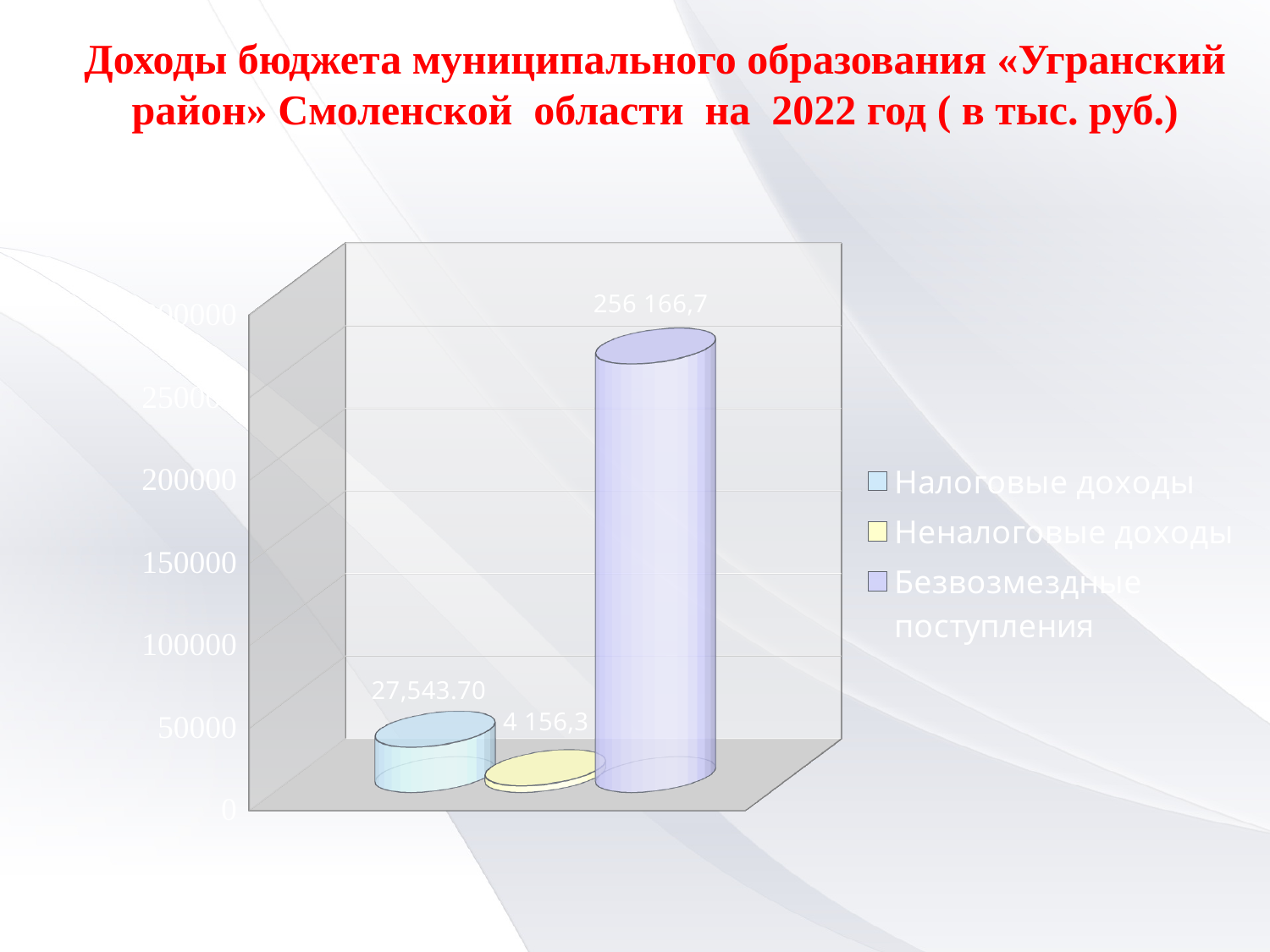
How many series does the legend list? 3 What is the value for Неналоговые доходы? 4 156,3 What colour is the bar for Неналоговые доходы? yellow What is the value for Безвозмездные поступления? 256 166,7 Which is larger, Налоговые доходы or Неналоговые доходы? Налоговые доходы What is the value for Налоговые доходы? 27,543.70 Which series has the highest value? Безвозмездные поступления Is the value for Безвозмездные поступления greater or less than 250000? greater What kind of chart is shown on the slide? bar chart Is the value for Налоговые доходы greater or less than 50000? less What is the highest value shown on the vertical axis? 300000 Which series has the lowest value? Неналоговые доходы